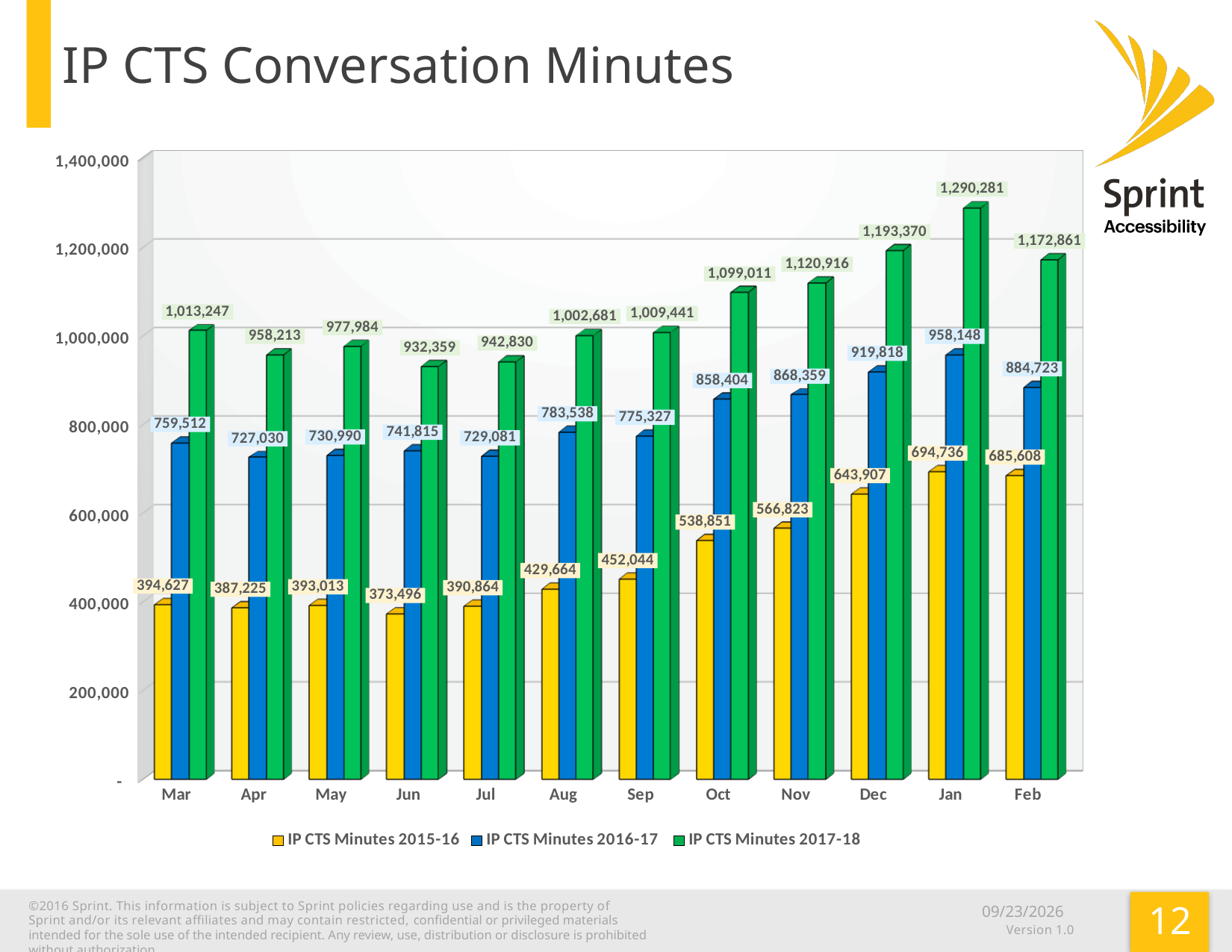
What kind of chart is shown on the slide? Bar chart Which month has the lowest value for IP CTS Minutes 2015-16? Jun What is the difference between IP CTS Minutes 2016-17 and IP CTS Minutes 2015-16 in Mar? 364,885 Which is larger: IP CTS Minutes 2016-17 in Dec or IP CTS Minutes 2016-17 in Feb? Dec Which colour represents IP CTS Minutes 2017-18 in the legend? Green How many series does the legend list? 3 How many months are shown on the x axis? 12 What is the difference between IP CTS Minutes 2017-18 and IP CTS Minutes 2016-17 in Jan? 332,133 What is the value for IP CTS Minutes 2016-17 in Oct? 858,404 What is the value for IP CTS Minutes 2017-18 in Jan? 1,290,281 Which month has the highest value for IP CTS Minutes 2017-18? Jan What is the value for IP CTS Minutes 2015-16 in Jun? 373,496